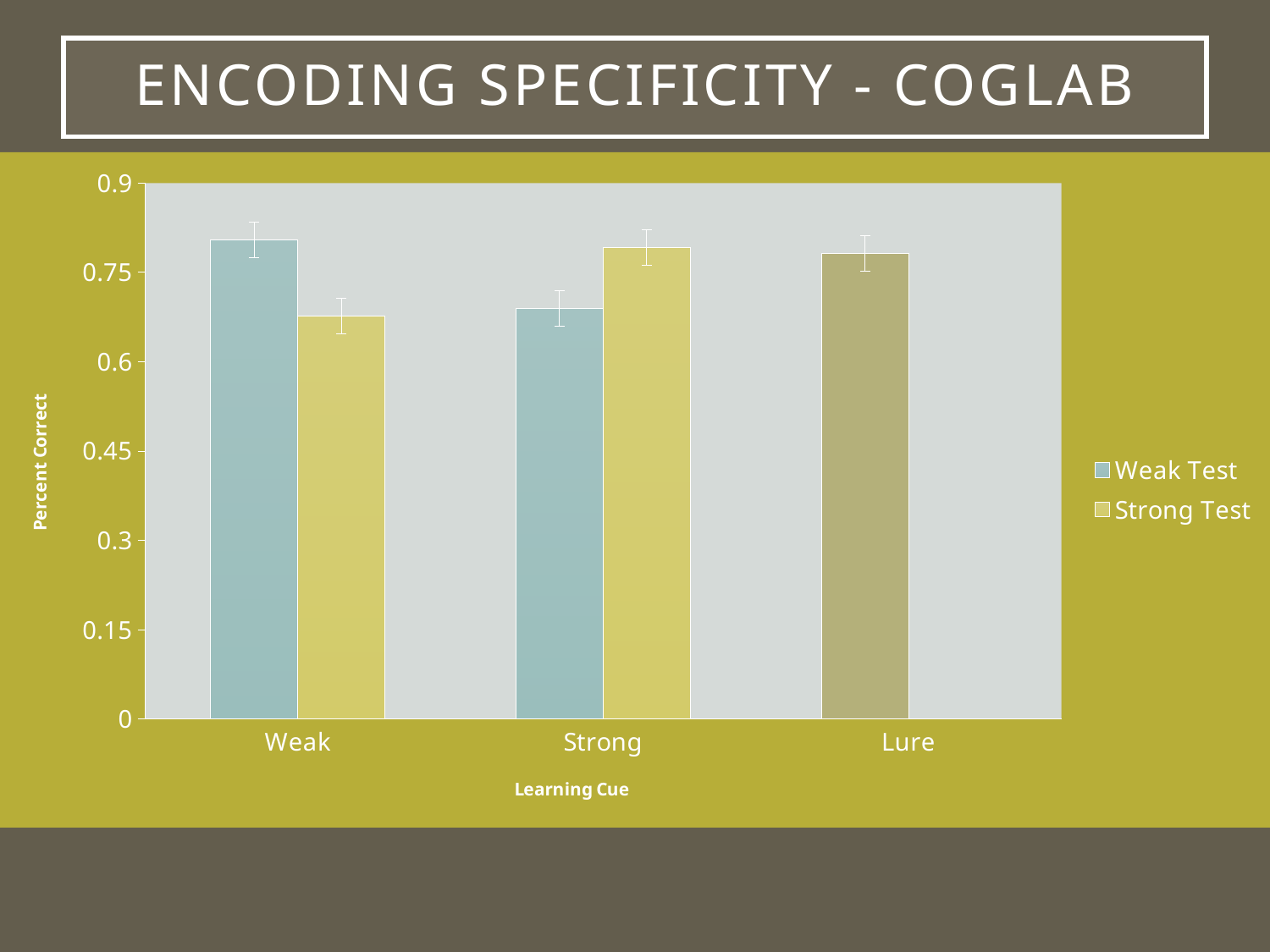
How many series does the legend list? 2 Is the Strong Test value for the Strong learning cue greater or less than 0.75? greater For the Weak learning cue, which is larger: the Weak Test value or the Strong Test value? Weak Test What is the title of the vertical axis? Percent Correct How many learning cue categories are shown on the x axis? 3 Is the value for the Lure learning cue greater or less than 0.6? greater Is the Strong Test value for the Weak learning cue greater or less than 0.75? less What is the title of the horizontal axis? Learning Cue For the Strong learning cue, which is larger: the Weak Test value or the Strong Test value? Strong Test What kind of chart is shown on the slide? bar chart